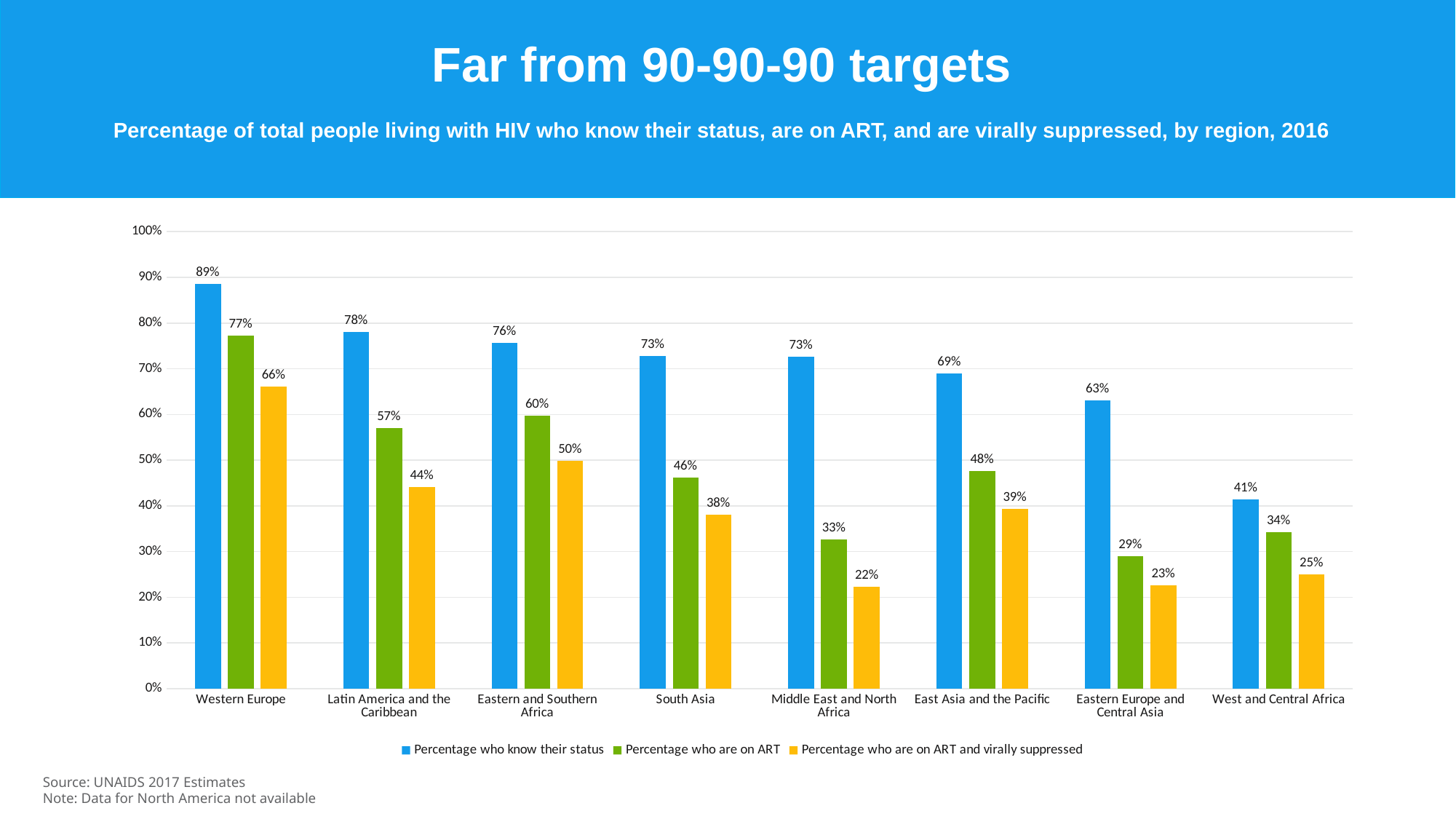
Which region has the highest percentage who know their status? Western Europe How many regions are shown on the x axis? 8 Which colour represents the percentage who are on ART and virally suppressed? Yellow What is the percentage who are on ART and virally suppressed in Middle East and North Africa? 22% What kind of chart is shown on the slide? Bar chart What is the difference between the percentage who know their status and the percentage who are on ART in Latin America and the Caribbean? 21% Which region has the lowest percentage who are on ART and virally suppressed? Middle East and North Africa Which is larger: the percentage on ART in South Asia or the percentage on ART in East Asia and the Pacific? East Asia and the Pacific What percentage of people living with HIV in Western Europe know their status? 89% Do the values for the percentage who know their status rise or fall from left to right across the regions? Fall What is the percentage who are on ART in Eastern and Southern Africa? 60% How many series does the legend list? 3